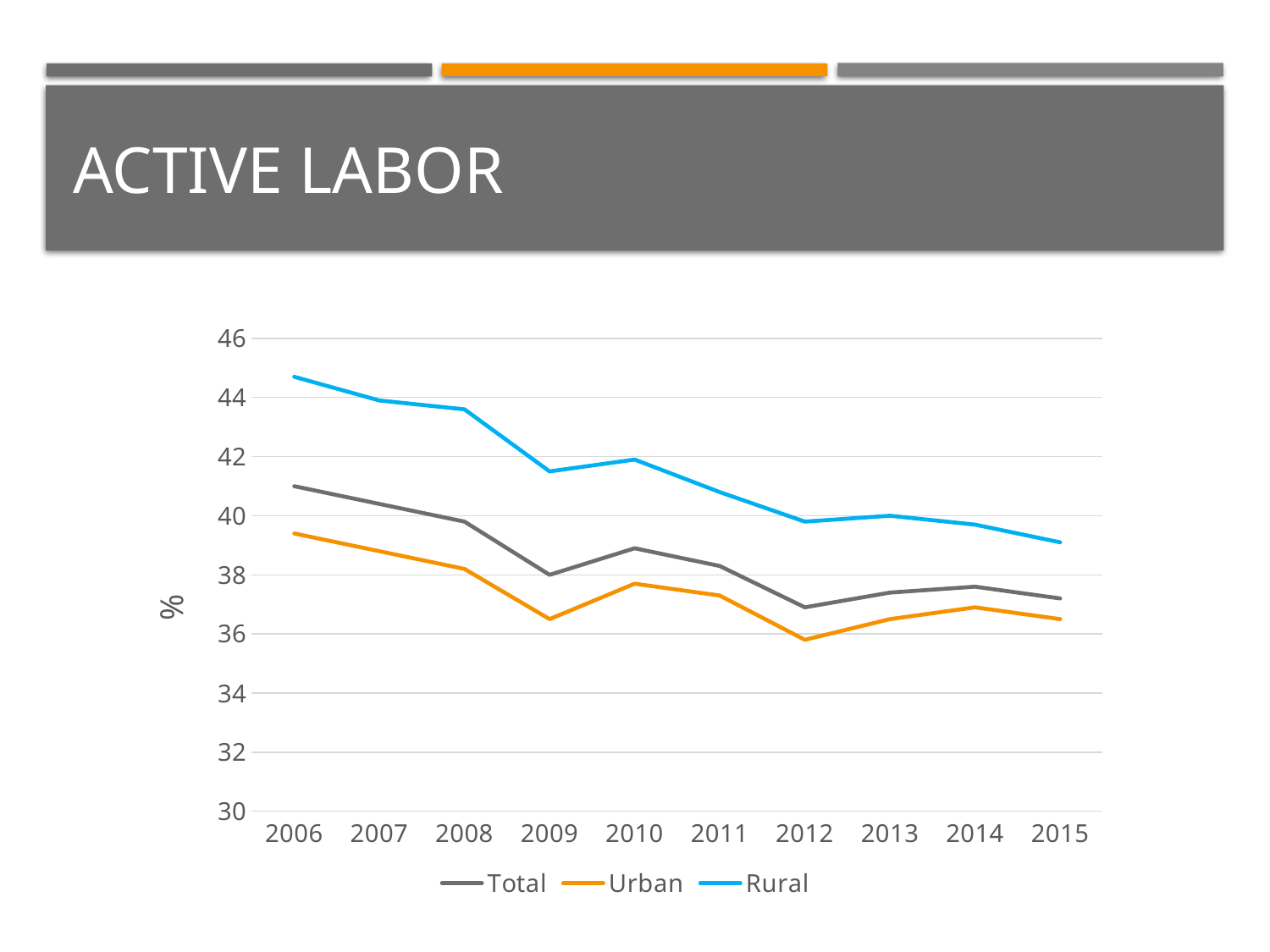
Is the Urban value for 2009 greater or less than 38? less What label is shown on the vertical axis? % Overall, do the Total values rise or fall from 2006 to 2015? fall What kind of chart is shown on the slide? line chart How many series does the legend list? 3 Is the Rural value for 2006 greater or less than 44? greater Which series has the highest values across all years? Rural In which year is the Urban value lowest? 2012 How many years are plotted along the x axis? 10 Is the Rural value for 2015 greater or less than 40? less Which series has the lowest values across all years? Urban In which year is the Rural value highest? 2006